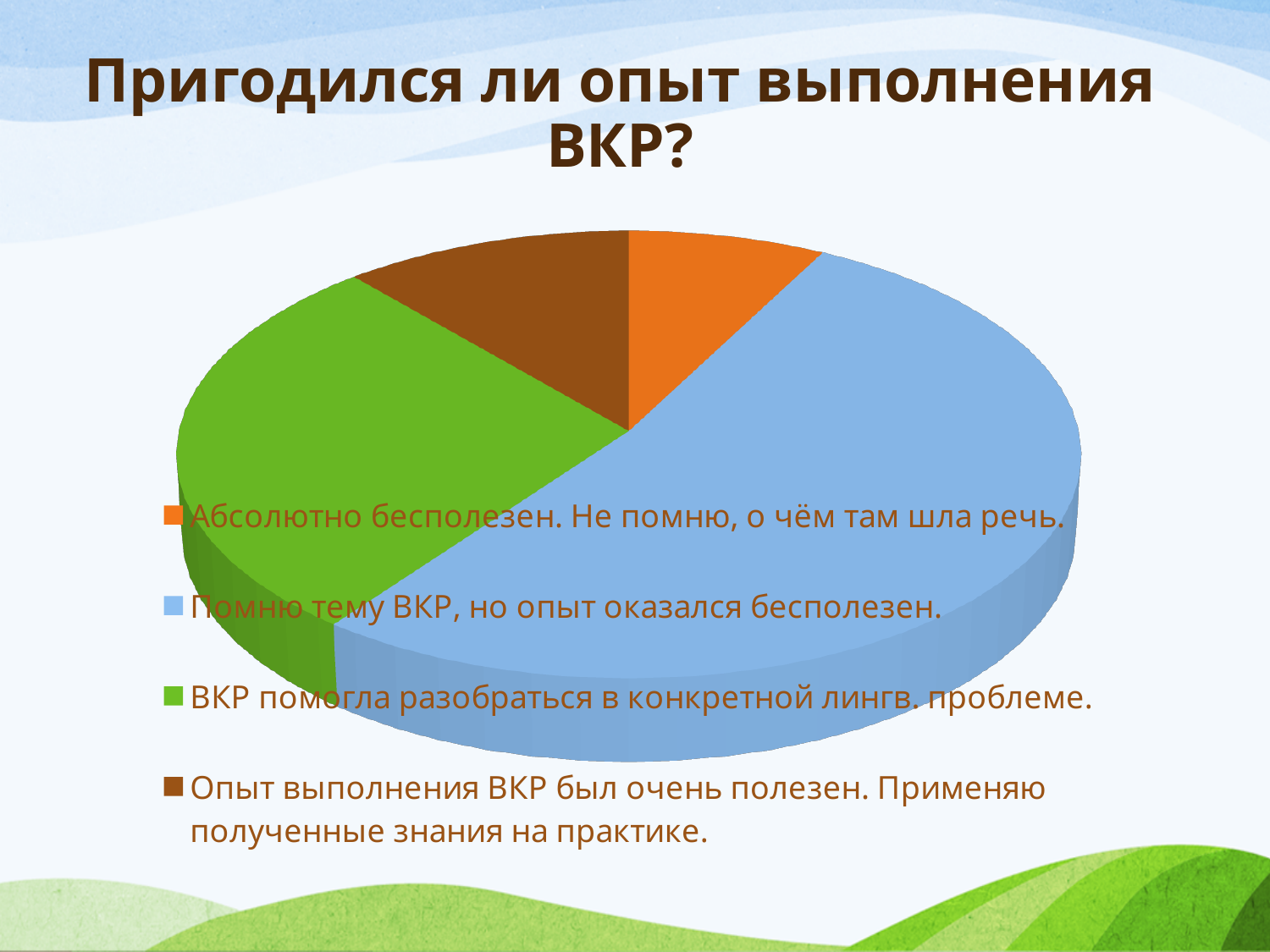
How many slices does the pie chart have? 4 Which slice is larger: "Помню тему ВКР, но опыт оказался бесполезен." or "Опыт выполнения ВКР был очень полезен. Применяю полученные знания на практике."? Помню тему ВКР, но опыт оказался бесполезен. Which slice is larger: "Помню тему ВКР, но опыт оказался бесполезен." or "ВКР помогла разобраться в конкретной лингв. проблеме."? Помню тему ВКР, но опыт оказался бесполезен. What colour is the slice for "ВКР помогла разобраться в конкретной лингв. проблеме."? Green Which slice is larger: "ВКР помогла разобраться в конкретной лингв. проблеме." or "Опыт выполнения ВКР был очень полезен. Применяю полученные знания на практике."? ВКР помогла разобраться в конкретной лингв. проблеме. What is the title of the slide with the pie chart? Пригодился ли опыт выполнения ВКР? Which category has the largest slice of the pie? Помню тему ВКР, но опыт оказался бесполезен. How many entries does the legend list? 4 What kind of chart is shown on the slide? Pie chart